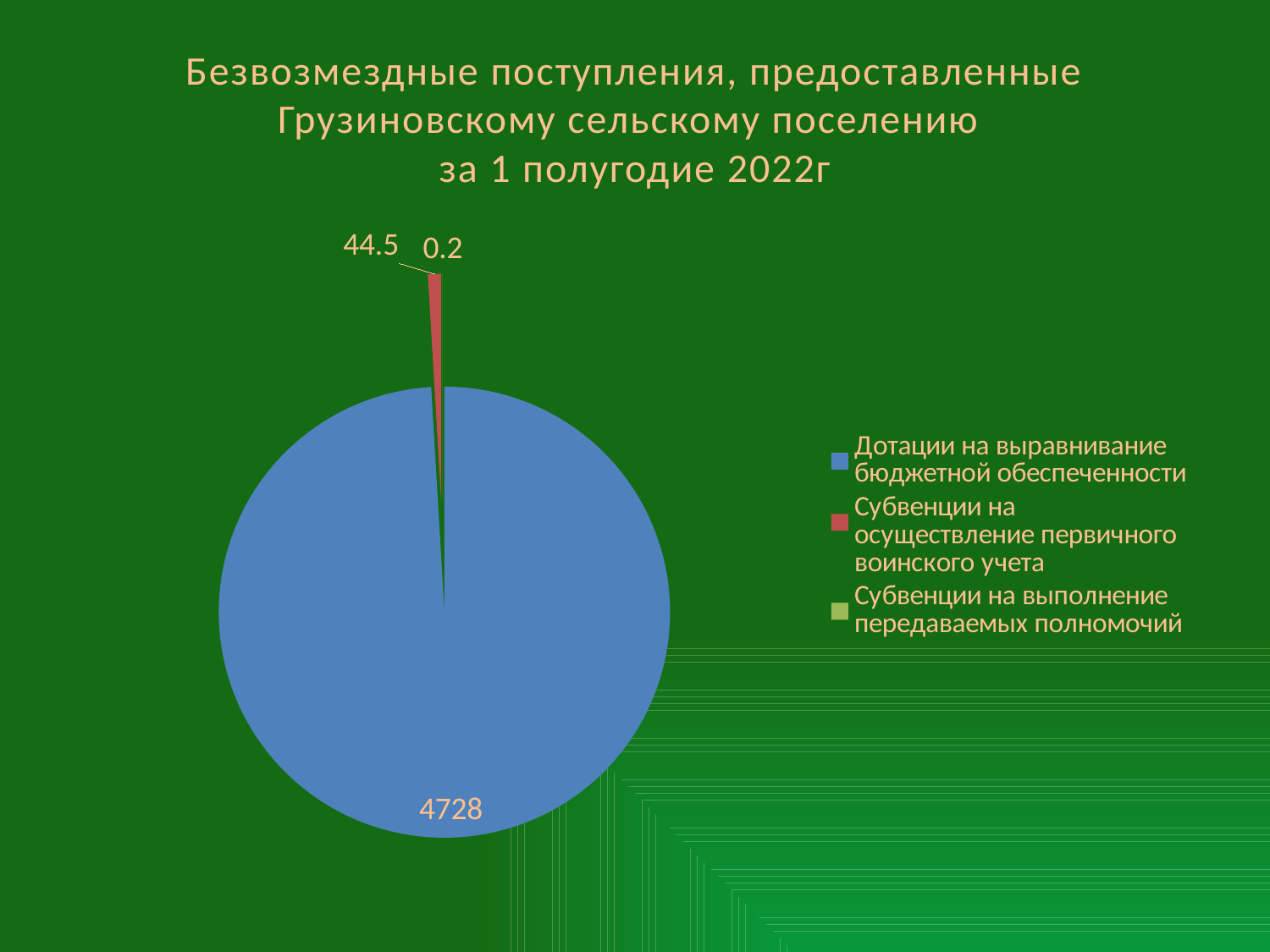
Which category has the smallest slice of the pie? Субвенции на выполнение передаваемых полномочий What is the difference between the value for Субвенции на осуществление первичного воинского учета and the value for Субвенции на выполнение передаваемых полномочий? 44.3 What is the value for Субвенции на выполнение передаваемых полномочий? 0.2 Which category has the largest slice of the pie? Дотации на выравнивание бюджетной обеспеченности What is the value for Дотации на выравнивание бюджетной обеспеченности? 4728 Which is larger: the value for Субвенции на осуществление первичного воинского учета or the value for Субвенции на выполнение передаваемых полномочий? Субвенции на осуществление первичного воинского учета How many slices does the pie chart have? 3 What is the difference between the value for Дотации на выравнивание бюджетной обеспеченности and the value for Субвенции на осуществление первичного воинского учета? 4683.5 How many entries does the legend list? 3 What kind of chart is shown on the slide? pie chart What colour is the slice for Дотации на выравнивание бюджетной обеспеченности? blue What is the value for Субвенции на осуществление первичного воинского учета? 44.5